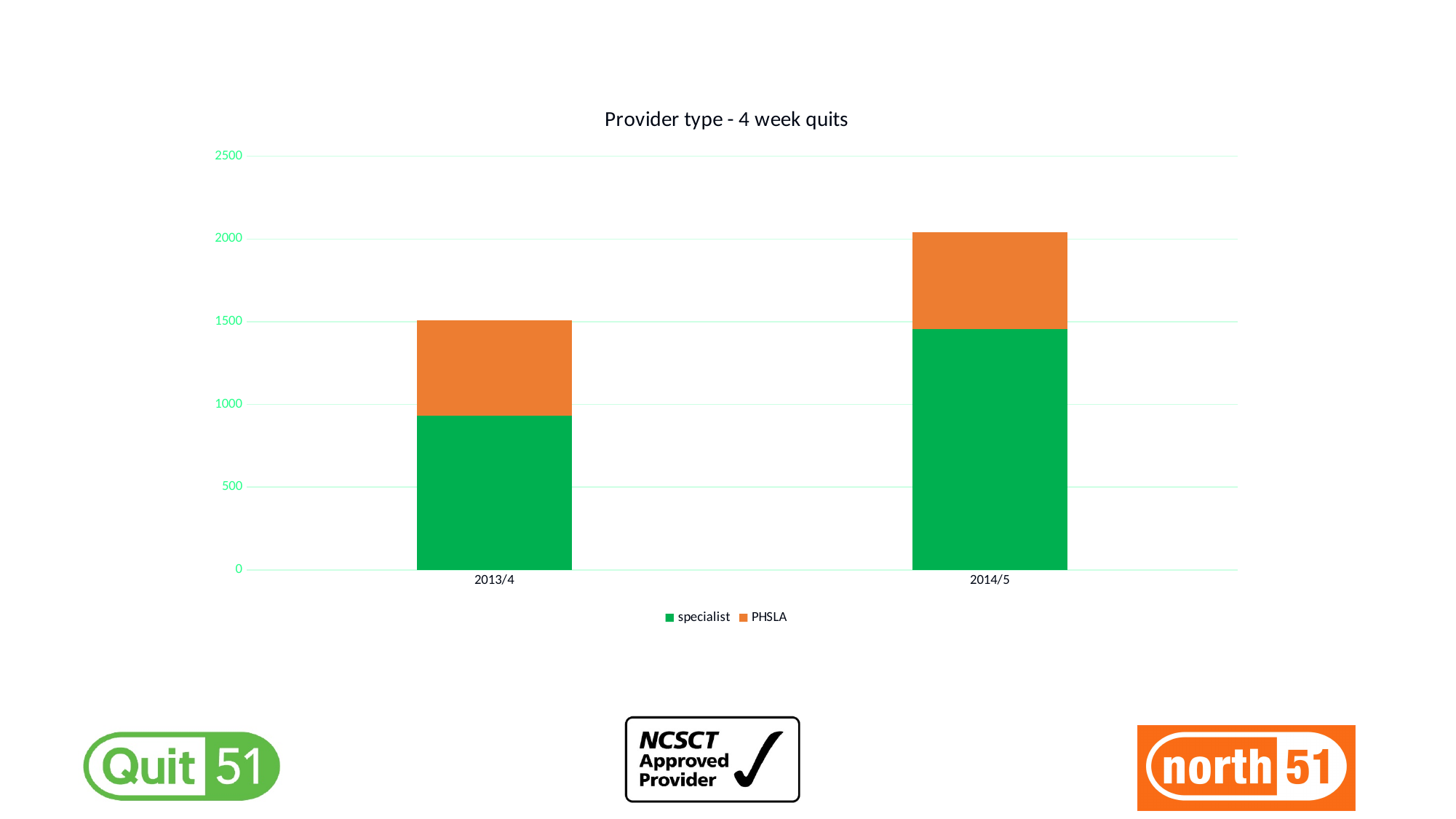
What is the title of the chart? Provider type - 4 week quits Is the total stacked bar for 2014/5 greater or less than 1500? greater Is the specialist value for 2014/5 greater or less than 1000? greater Do the total 4 week quits rise or fall from 2013/4 to 2014/5? rise How many categories are shown on the x axis? 2 How many series does the legend list? 2 Which year has the lowest total 4 week quits? 2013/4 Which series are listed in the legend? specialist and PHSLA What type of chart is shown on the slide? stacked bar chart Which year has the highest total 4 week quits? 2014/5 Is the specialist value for 2013/4 greater or less than 1000? less Which year has the larger specialist value, 2013/4 or 2014/5? 2014/5